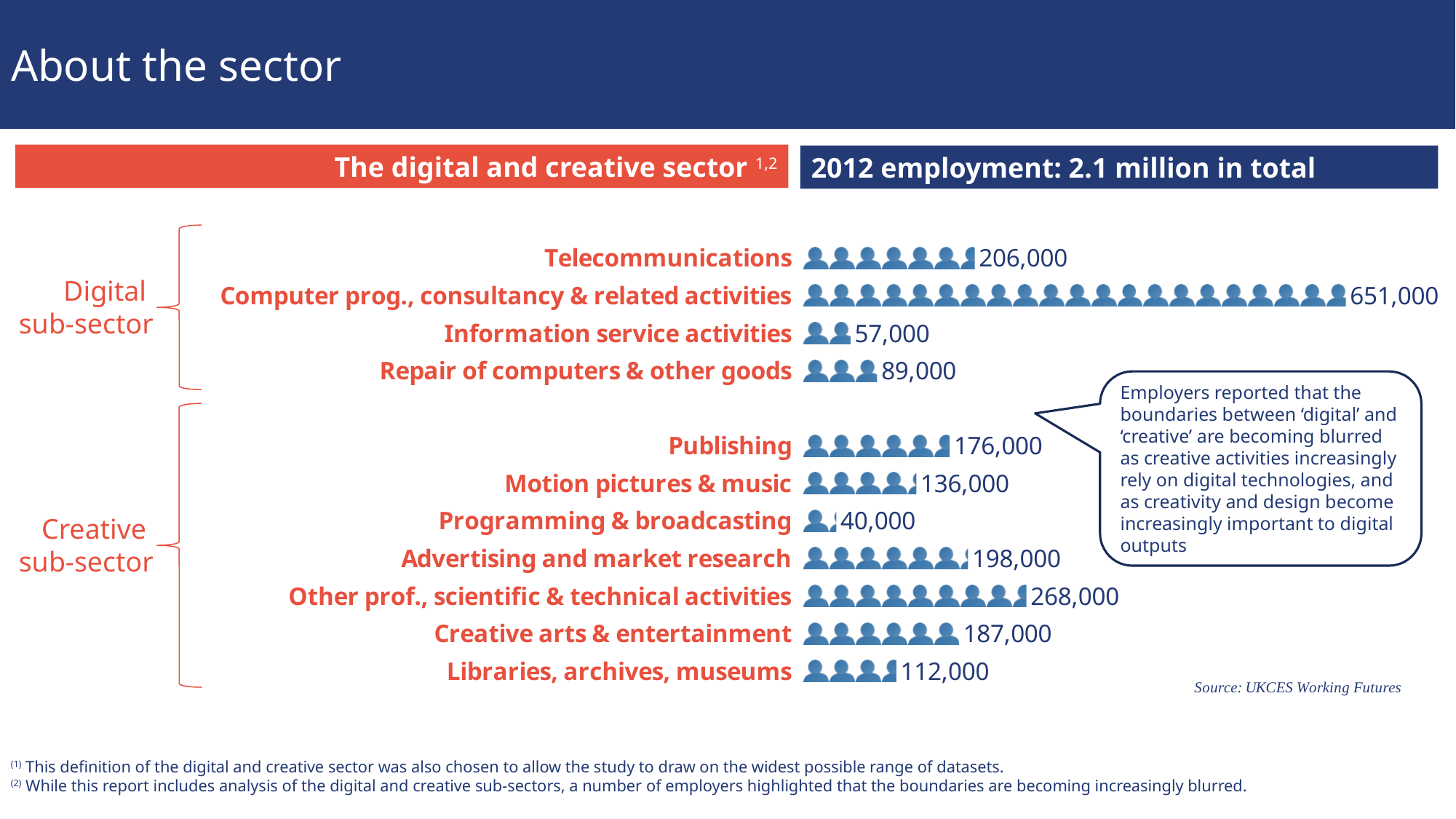
What is the 2012 employment figure shown for Libraries, archives, museums? 112,000 What kind of chart is used to show the employment figures? Pictogram chart What is the source cited for the chart? UKCES Working Futures What is the 2012 employment figure shown for Publishing? 176,000 What is the difference in 2012 employment between Other prof., scientific & technical activities and Creative arts & entertainment? 81,000 Which has higher 2012 employment: Advertising and market research or Motion pictures & music? Advertising and market research How many categories are listed under the Creative sub-sector? 7 What is the total 2012 employment of the four Digital sub-sector categories? 1,003,000 Which category has the highest 2012 employment on the chart? Computer prog., consultancy & related activities What is the 2012 employment figure shown for Telecommunications? 206,000 Which category has the lowest 2012 employment on the chart? Programming & broadcasting How many categories are shown on the chart in total? 11